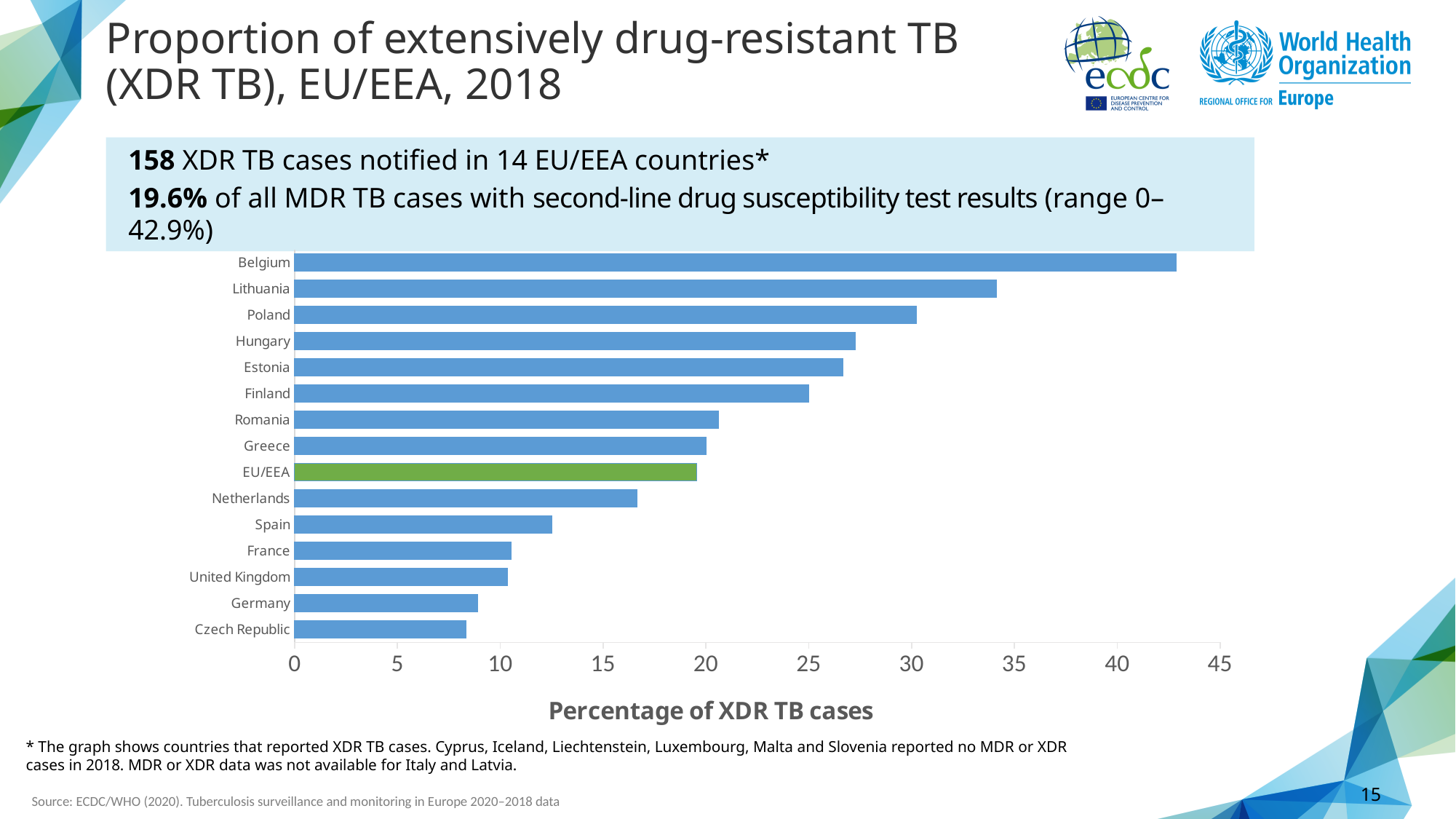
Which category has the lowest percentage of XDR TB cases? Czech Republic Is the value for Netherlands greater or less than 20? less Is the value for Lithuania greater or less than 30? greater Is the value for Hungary greater or less than 25? greater Which has a higher percentage of XDR TB cases, Spain or France? Spain Which category has the highest percentage of XDR TB cases? Belgium What is the title of the horizontal axis? Percentage of XDR TB cases How many bars are plotted in the chart? 15 What kind of chart is shown on the slide? bar chart Which has a higher percentage of XDR TB cases, Belgium or Lithuania? Belgium